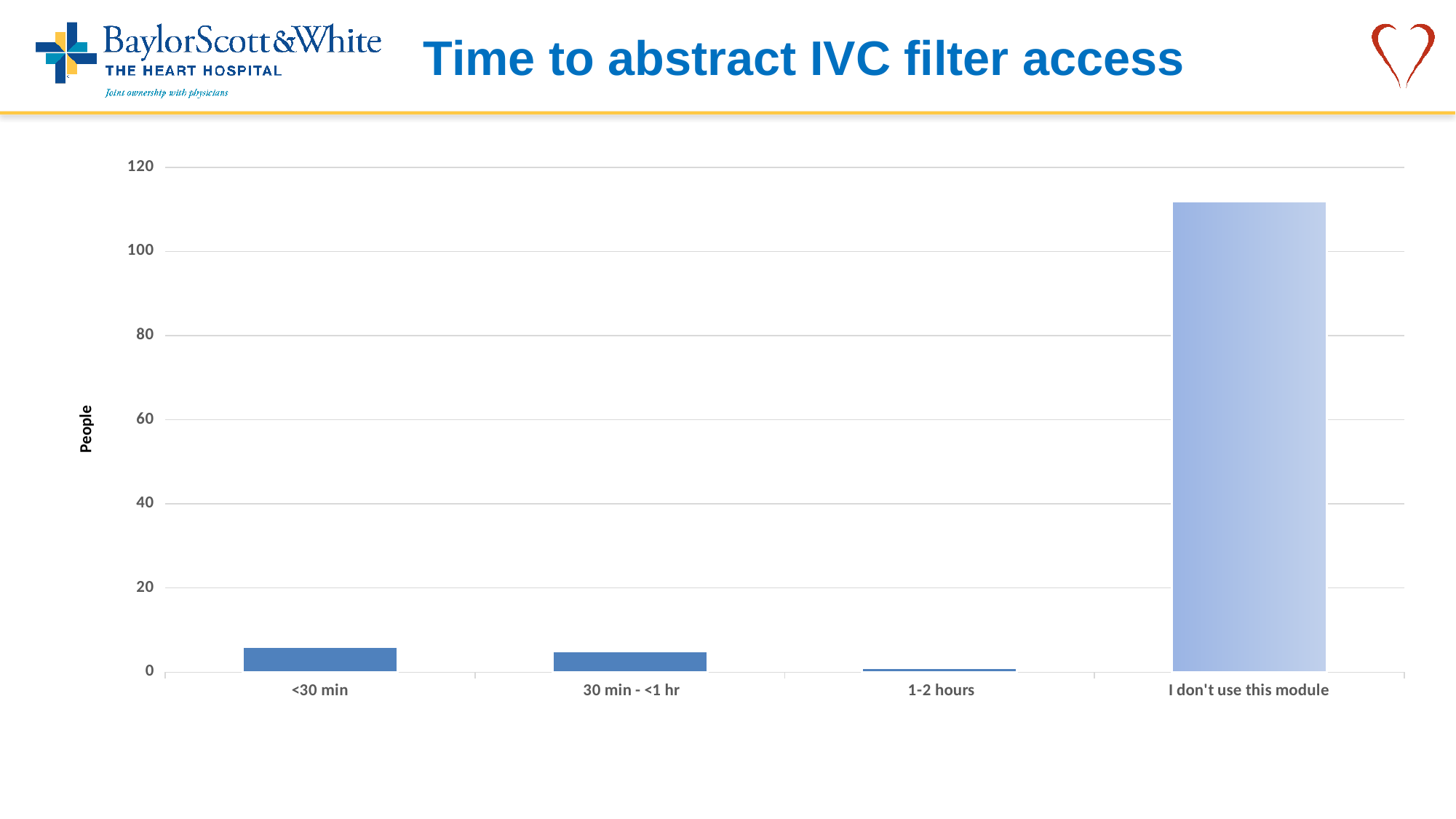
Is the value for "30 min - <1 hr" greater or less than 20? less What is the label on the y axis of the chart? People Which category has the lowest value in the chart? 1-2 hours Is the value for "I don't use this module" greater or less than 100? greater Which is larger, the value for "<30 min" or the value for "1-2 hours"? <30 min Which category has the highest value in the chart? I don't use this module How many categories are shown on the x axis of the chart? 4 Which is larger, the value for "I don't use this module" or the value for "<30 min"? I don't use this module What is the title of the chart on the slide? Time to abstract IVC filter access Is the value for "<30 min" greater or less than 20? less What kind of chart is shown on the slide? bar chart